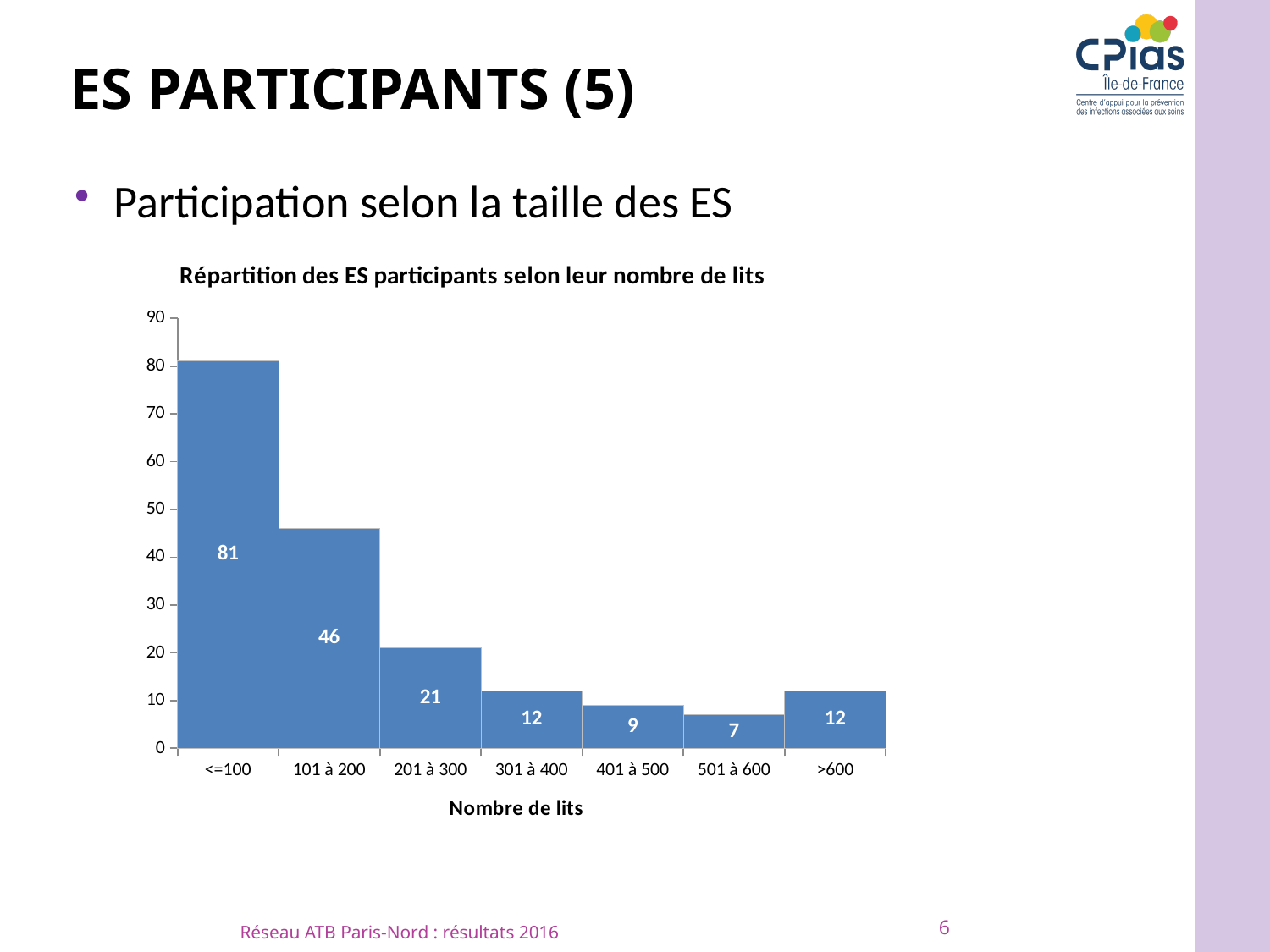
What kind of chart is shown? bar chart What is the value for the '<=100' category? 81 Is the value for '101 à 200' greater or less than 50? less Which category has the lowest value? 501 à 600 What is the value for the '401 à 500' category? 9 What is the difference between the values for '<=100' and '101 à 200'? 35 What is the value for the '101 à 200' category? 46 What is the title of the chart? Répartition des ES participants selon leur nombre de lits Which category has the highest value? <=100 Which is larger: the value for '201 à 300' or the value for '>600'? 201 à 300 What is the x-axis title of the chart? Nombre de lits How many categories are shown on the x axis? 7